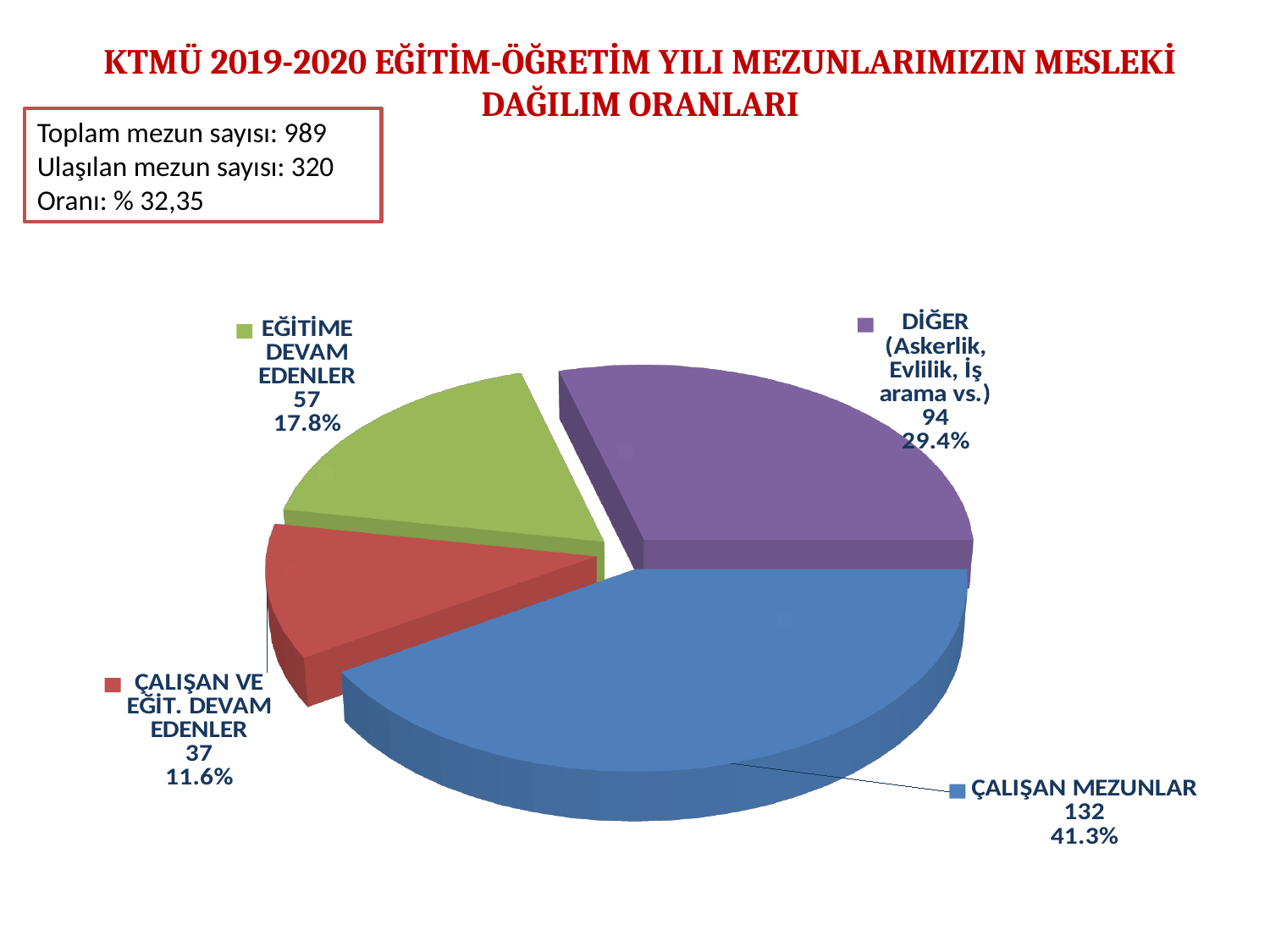
What share of the pie does DİĞER (Askerlik, Evlilik, İş arama vs.) represent? 29.4% Which category has the smallest slice? ÇALIŞAN VE EĞİT. DEVAM EDENLER How many slices does the pie chart have? 4 Which category has the largest slice? ÇALIŞAN MEZUNLAR What share of the pie does EĞİTİME DEVAM EDENLER represent? 17.8% What is the value for ÇALIŞAN MEZUNLAR? 132 What is the value for ÇALIŞAN VE EĞİT. DEVAM EDENLER? 37 Which is larger, the value for EĞİTİME DEVAM EDENLER or the value for ÇALIŞAN VE EĞİT. DEVAM EDENLER? EĞİTİME DEVAM EDENLER What is the difference between the values for ÇALIŞAN MEZUNLAR and DİĞER (Askerlik, Evlilik, İş arama vs.)? 38 What is the value for EĞİTİME DEVAM EDENLER? 57 What is the value for DİĞER (Askerlik, Evlilik, İş arama vs.)? 94 What kind of chart is shown on the slide? pie chart